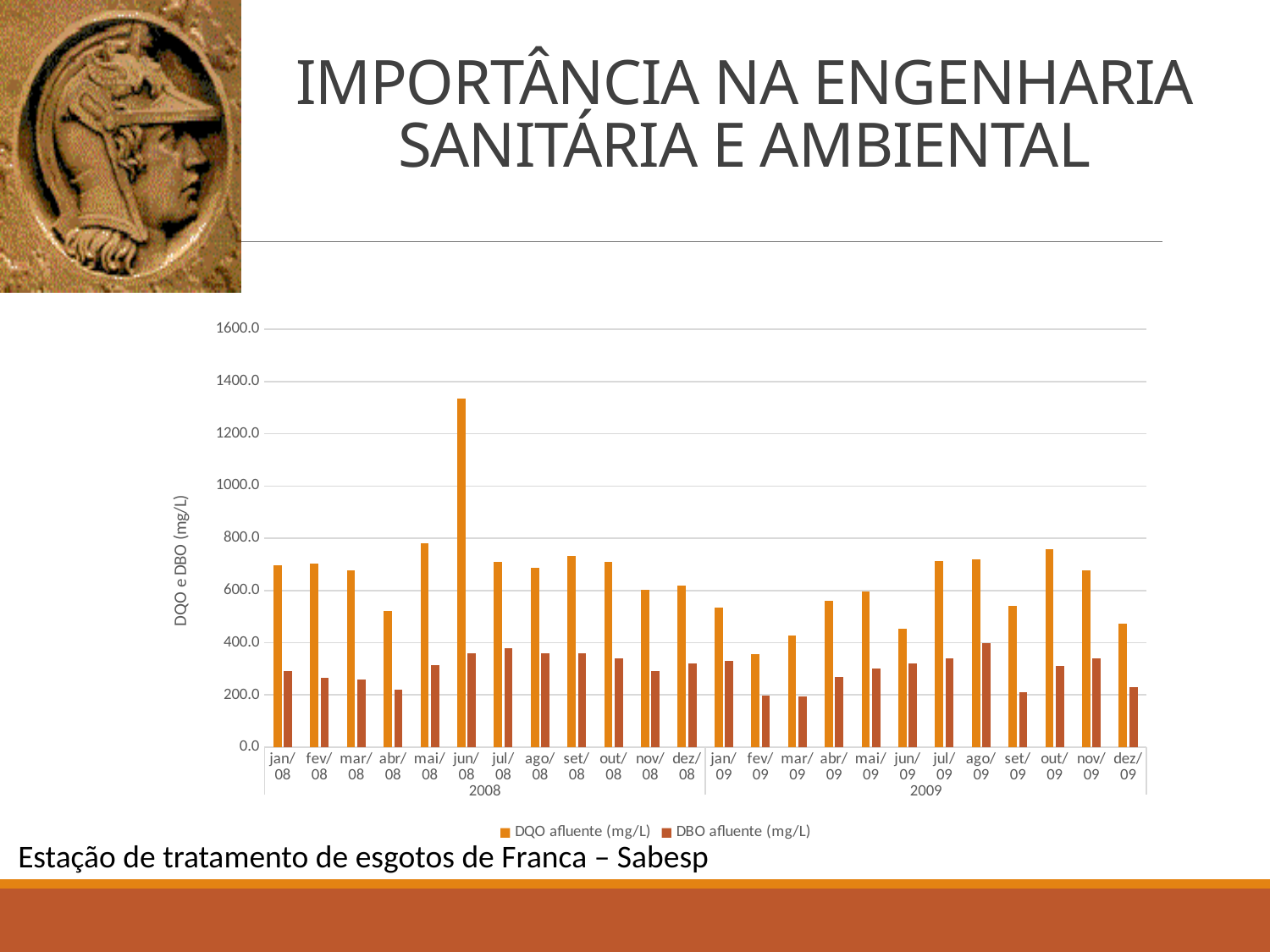
Is the DQO afluente (mg/L) value for out/09 greater or less than 600? greater How many series does the legend list? 2 In which month is the DQO afluente (mg/L) value lowest? fev/09 In which month is the DQO afluente (mg/L) value highest? jun/08 Which is larger, the DQO afluente (mg/L) value for mai/08 or for abr/08? mai/08 Is the DQO afluente (mg/L) value for fev/09 greater or less than 400? less Which is larger, the DBO afluente (mg/L) value for jul/08 or for abr/08? jul/08 Is the DQO afluente (mg/L) value for jun/08 greater or less than 1200? greater What is the label on the vertical axis of the chart? DQO e DBO (mg/L) What kind of chart is shown on the slide? bar chart How many months (categories) are plotted along the x axis? 24